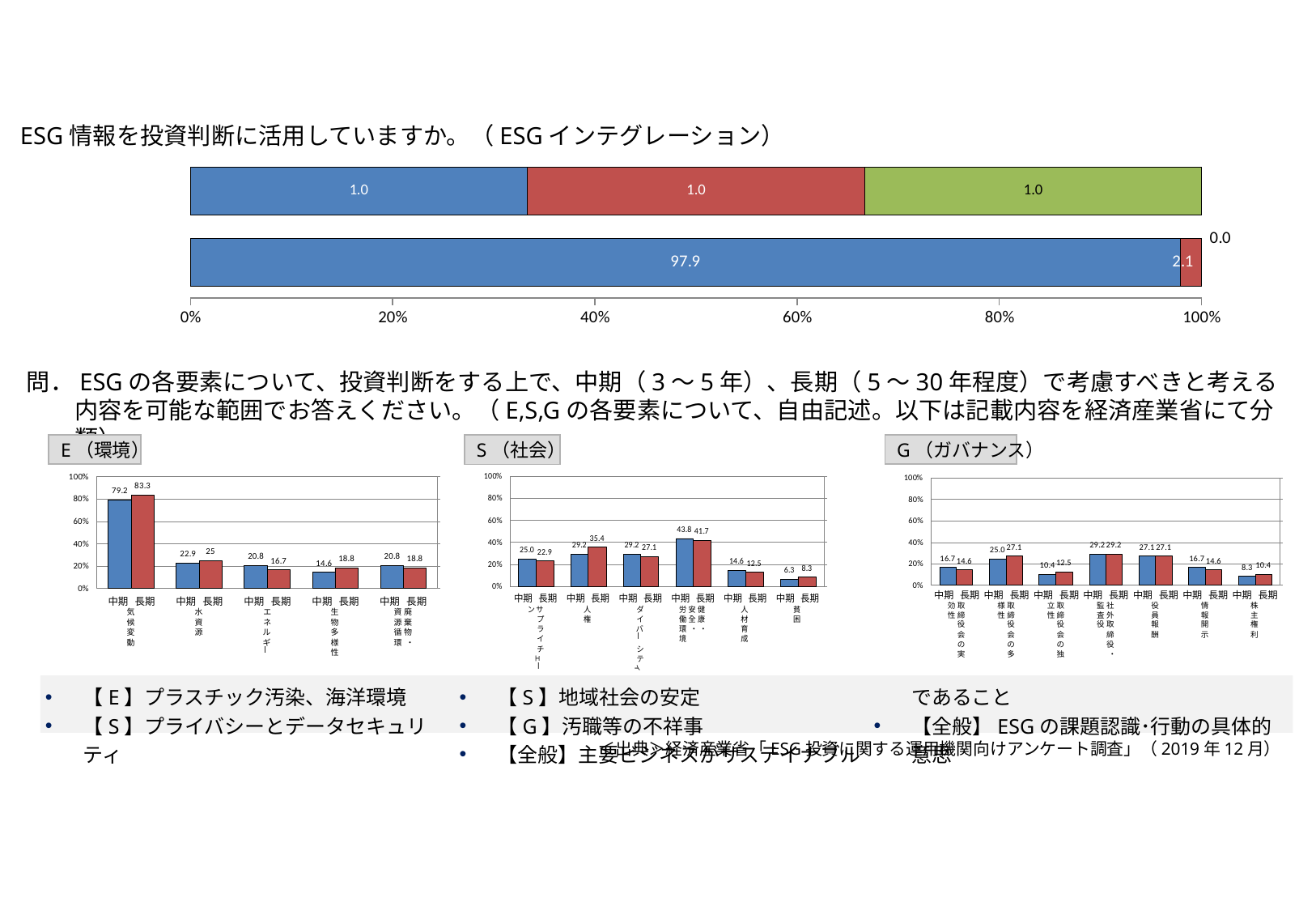
In the G（ガバナンス） chart, which is larger: the 中期 value for 役員報酬 or the 中期 value for 株主権利? 役員報酬 In the S（社会） chart, which category has the lowest 中期 value? 貧困 In the E（環境） chart, what is the 長期 value for 気候変動? 83.3 What type of chart is the top chart (ESG 情報を投資判断に活用していますか)? Stacked horizontal bar chart In the top chart (ESG 情報を投資判断に活用していますか), what is the value of the largest blue segment in the lower bar? 97.9 In the S（社会） chart, what is the 中期 value for 労働環境・安全・健康? 43.8 In the top chart (ESG 情報を投資判断に活用していますか), how many segments make up the upper bar? 3 In the G（ガバナンス） chart, what is the 長期 value for 取締役会の多様性? 27.1 In the S（社会） chart, is the 長期 value for 人権 greater or less than 40%? less In the top chart (ESG 情報を投資判断に活用していますか), what is the value of the red segment in the lower bar? 2.1 In the E（環境） chart, what is the difference between the 中期 and 長期 values for 気候変動? 4.1 In the E（環境） chart, which category has the highest 中期 value? 気候変動